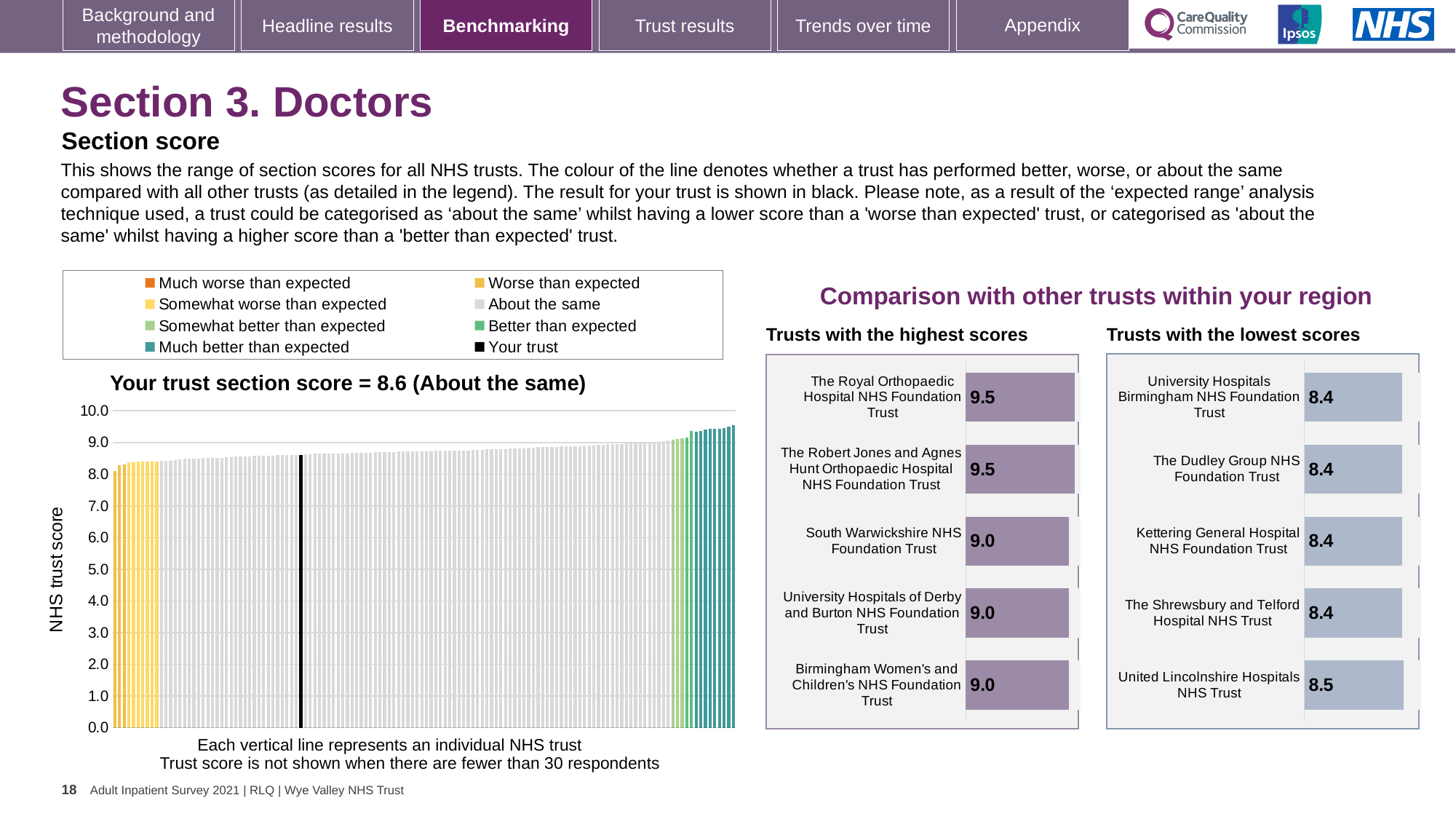
In the main chart on the left, is the value for your trust greater or less than 8.0? greater How many entries does the legend above the main chart on the left list? 8 In the 'Trusts with the highest scores' chart, how many trusts are listed? 5 In the main chart on the left, what is the section score for your trust? 8.6 In the 'Trusts with the lowest scores' chart, what is the score for Kettering General Hospital NHS Foundation Trust? 8.4 In the 'Trusts with the highest scores' chart, which has the larger score: The Royal Orthopaedic Hospital NHS Foundation Trust or Birmingham Women's and Children's NHS Foundation Trust? The Royal Orthopaedic Hospital NHS Foundation Trust In the main chart on the left, which category is your trust placed in according to the chart title? About the same In the 'Trusts with the highest scores' chart, what is the score for The Royal Orthopaedic Hospital NHS Foundation Trust? 9.5 In the 'Trusts with the lowest scores' chart, which trust has the highest score? United Lincolnshire Hospitals NHS Trust What kind of chart is the main chart on the left showing NHS trust scores? bar chart In the 'Trusts with the highest scores' chart, what is the difference between the scores of The Royal Orthopaedic Hospital NHS Foundation Trust and South Warwickshire NHS Foundation Trust? 0.5 In the main chart on the left, do the trust scores rise or fall from left to right along the x axis? rise